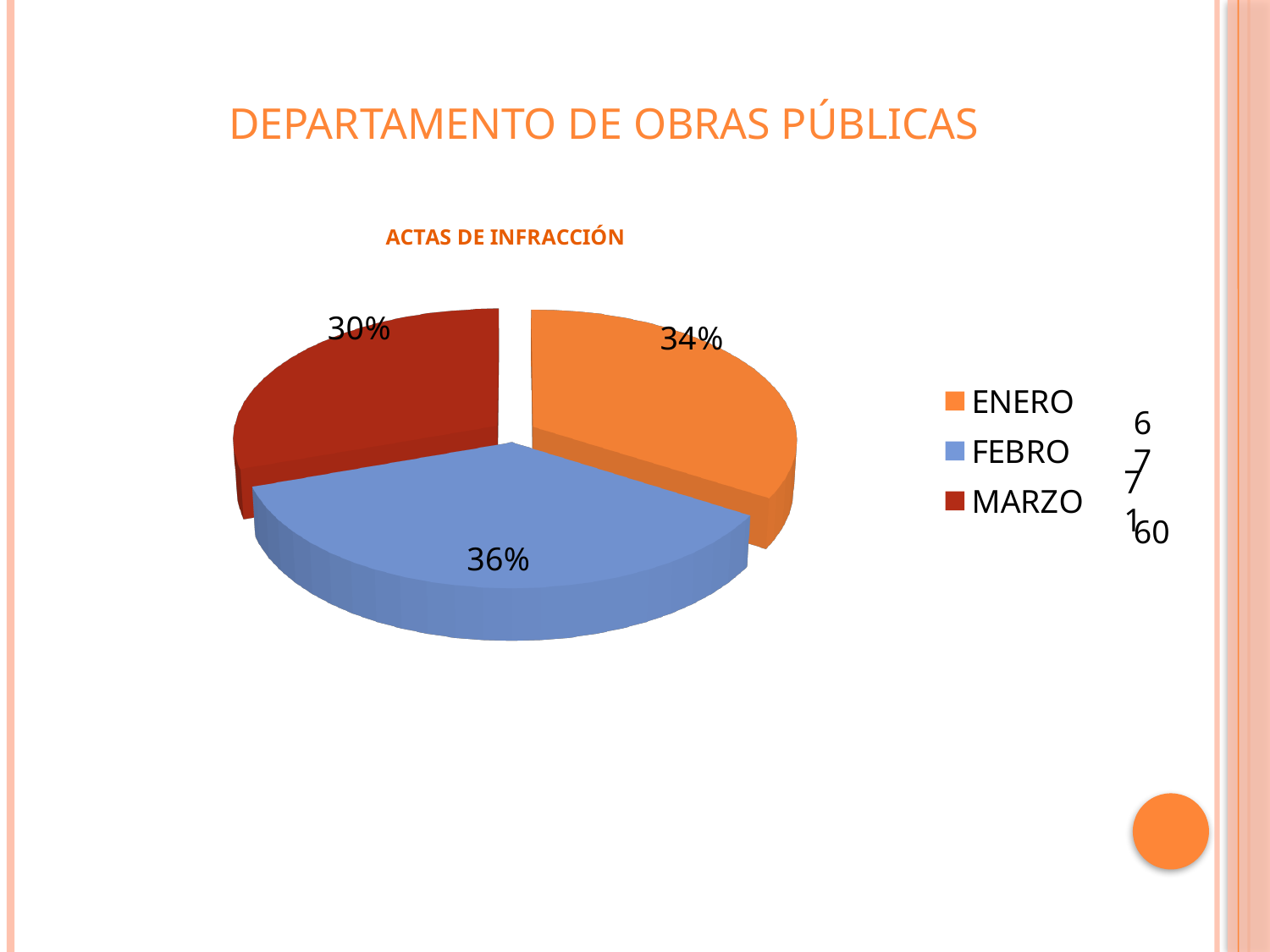
How many slices does the pie chart have? 3 What kind of chart is shown on the slide? Pie chart What colour is the slice for MARZO? Dark red Which is larger, the share for ENERO or the share for MARZO? ENERO Which month has the smallest share of the pie? MARZO What is the difference in percentage points between FEBRO and MARZO? 6 How many entries does the legend list? 3 What is the title of the chart? ACTAS DE INFRACCIÓN What percentage of the pie does MARZO represent? 30% Which month has the largest share of the pie? FEBRO What percentage of the pie does FEBRO represent? 36% What percentage of the pie does ENERO represent? 34%